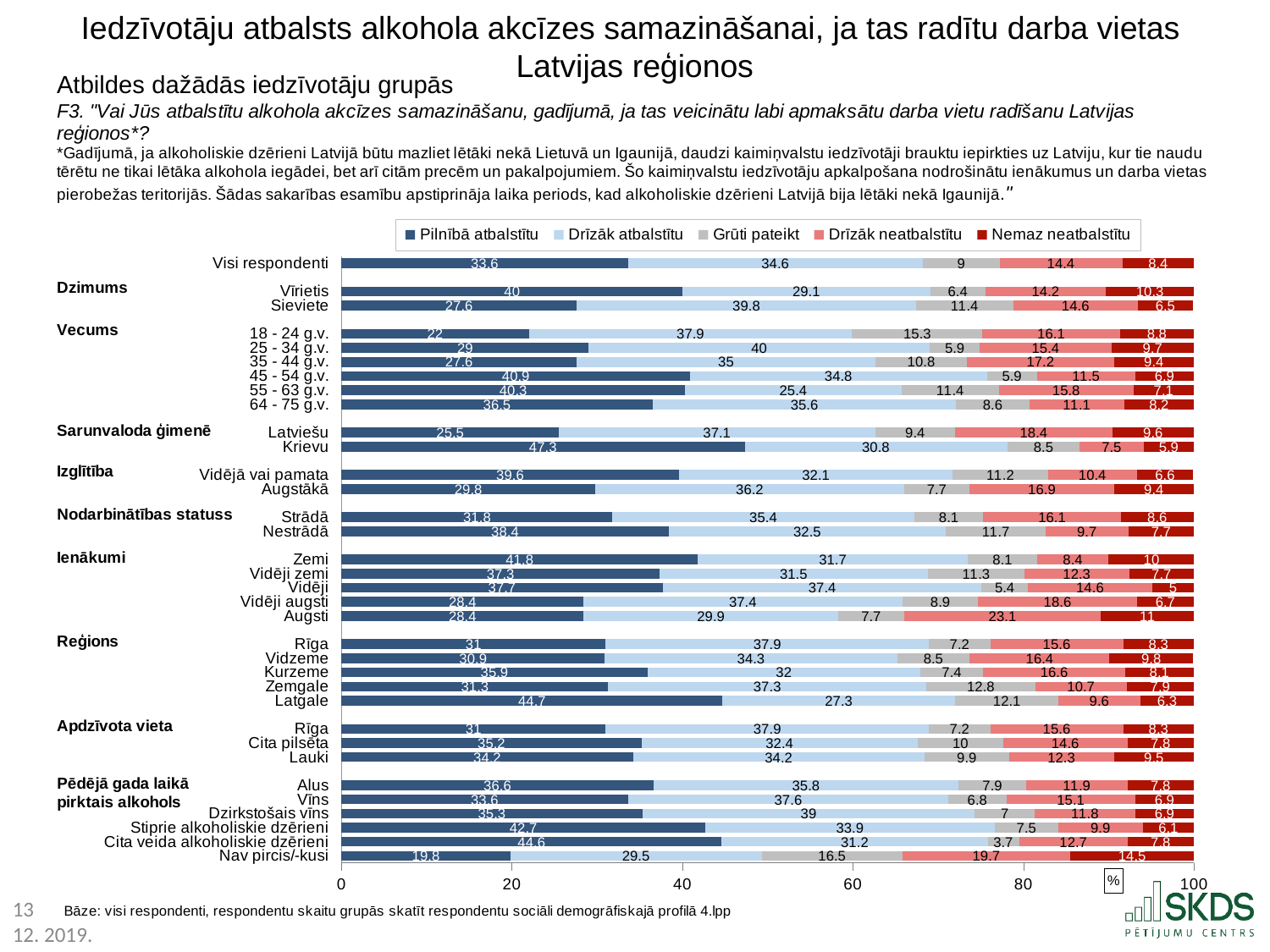
What kind of chart is shown on the slide? Stacked bar chart Which group has the highest "Pilnībā atbalstītu" value? Krievu What is the total of the stacked bar for Visi respondenti? 100 Which group has the lowest "Pilnībā atbalstītu" value? Nav pircis/-kusi Which has a larger "Drīzāk atbalstītu" value, Latviešu or Krievu? Latviešu What is the difference between the "Pilnībā atbalstītu" values for Vīrietis and Sieviete? 12.4 What percentage of all respondents (Visi respondenti) answered "Pilnībā atbalstītu"? 33.6 Is the "Pilnībā atbalstītu" value for Latgale greater or less than 40? greater Which legend entry is shown in dark red? Nemaz neatbalstītu What is the "Nemaz neatbalstītu" value for the Nav pircis/-kusi group? 14.5 What is the "Drīzāk neatbalstītu" value for the Augsti income group? 23.1 How many series does the legend list? 5